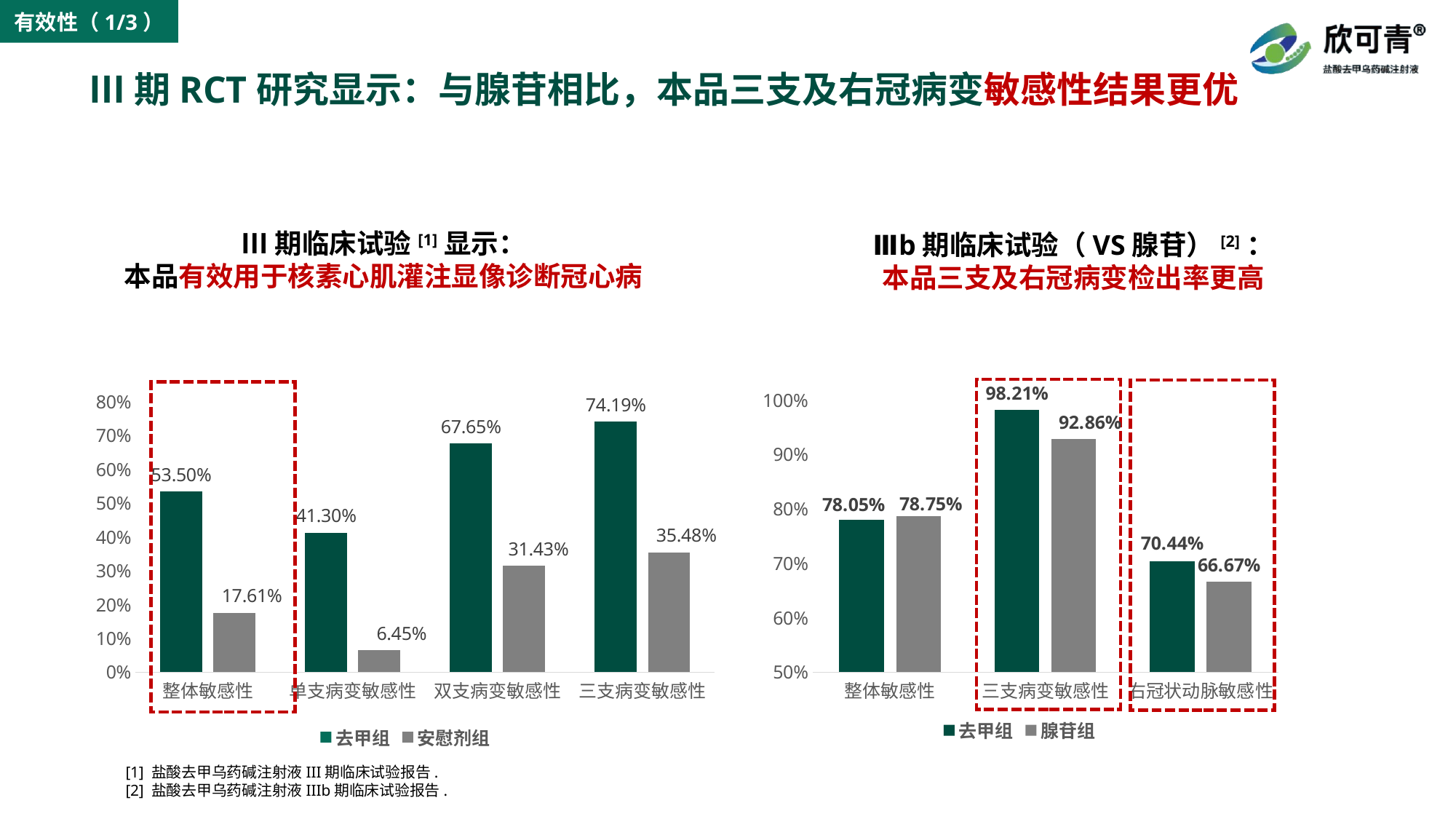
In the left chart, which category has the lowest value for 安慰剂组? 单支病变敏感性 In the right chart, what is the value for 去甲组 in the 右冠状动脉敏感性 category? 70.44% In the left chart, what is the value for 去甲组 in the 整体敏感性 category? 53.50% In the right chart, what is the difference between 去甲组 and 腺苷组 in the 三支病变敏感性 category? 5.35% What type of chart is the right chart? Bar chart In the right chart, how many series does the legend list? 2 In the left chart, what is the value for 安慰剂组 in the 单支病变敏感性 category? 6.45% In the right chart, which is larger in the 整体敏感性 category, 去甲组 or 腺苷组? 腺苷组 In the left chart, which category has the highest value for 去甲组? 三支病变敏感性 In the left chart, what is the difference between 去甲组 and 安慰剂组 in the 双支病变敏感性 category? 36.22% In the right chart, what is the value for 腺苷组 in the 三支病变敏感性 category? 92.86% In the left chart, how many categories are shown on the x axis? 4